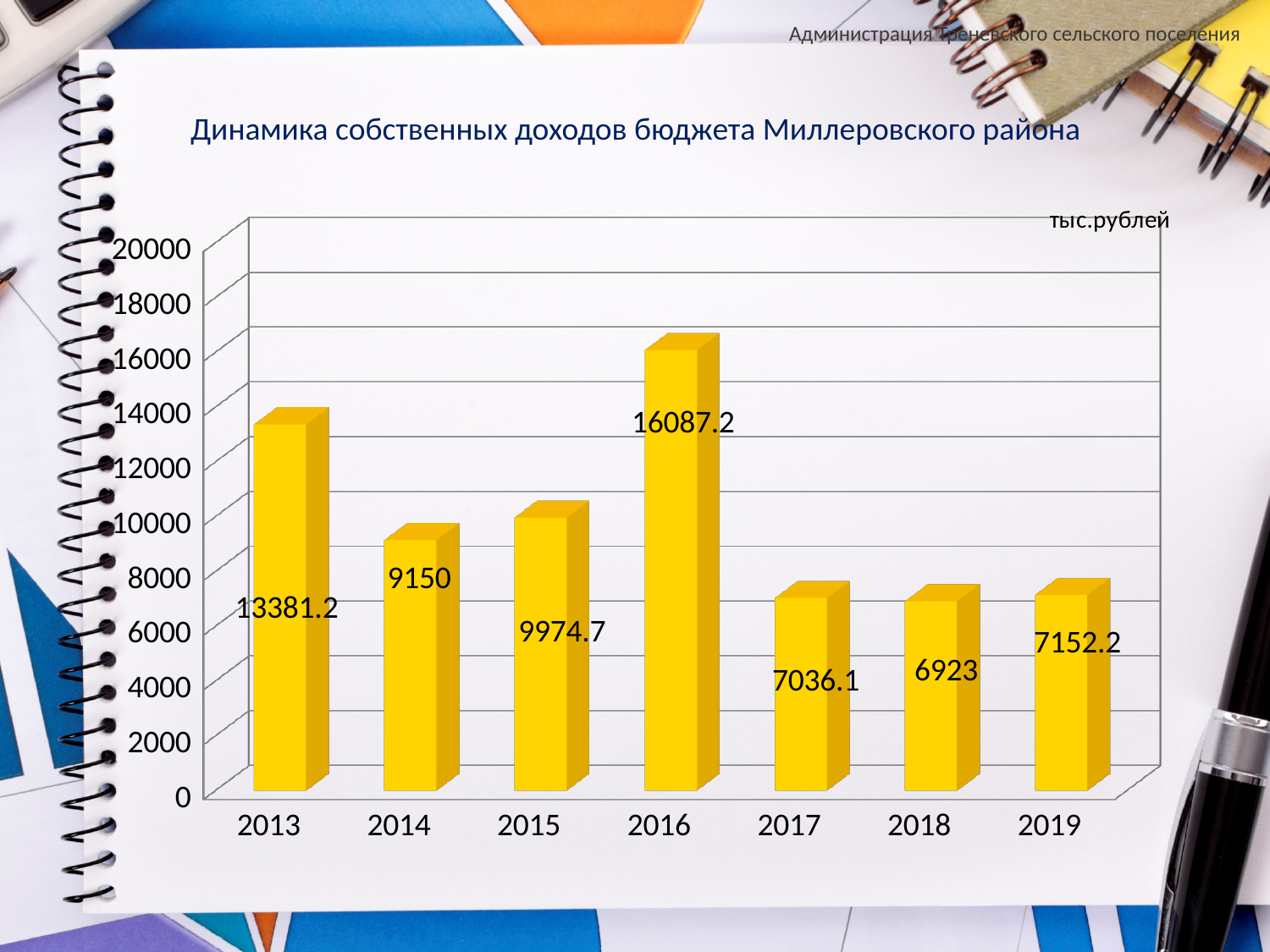
What is the value for 2013? 13381.2 How many years are shown on the x axis? 7 What is the difference between the values for 2019 and 2018? 229.2 What is the difference between the values for 2016 and 2013? 2706 Which year has the highest value? 2016 Which year has the lowest value? 2018 What kind of chart is shown on the slide? bar chart What unit is indicated in the top right corner of the chart? тыс.рублей Which is larger, the value for 2014 or the value for 2015? 2015 What is the value for 2018? 6923 What is the value for 2016? 16087.2 Is the value for 2017 greater or less than 8000? less